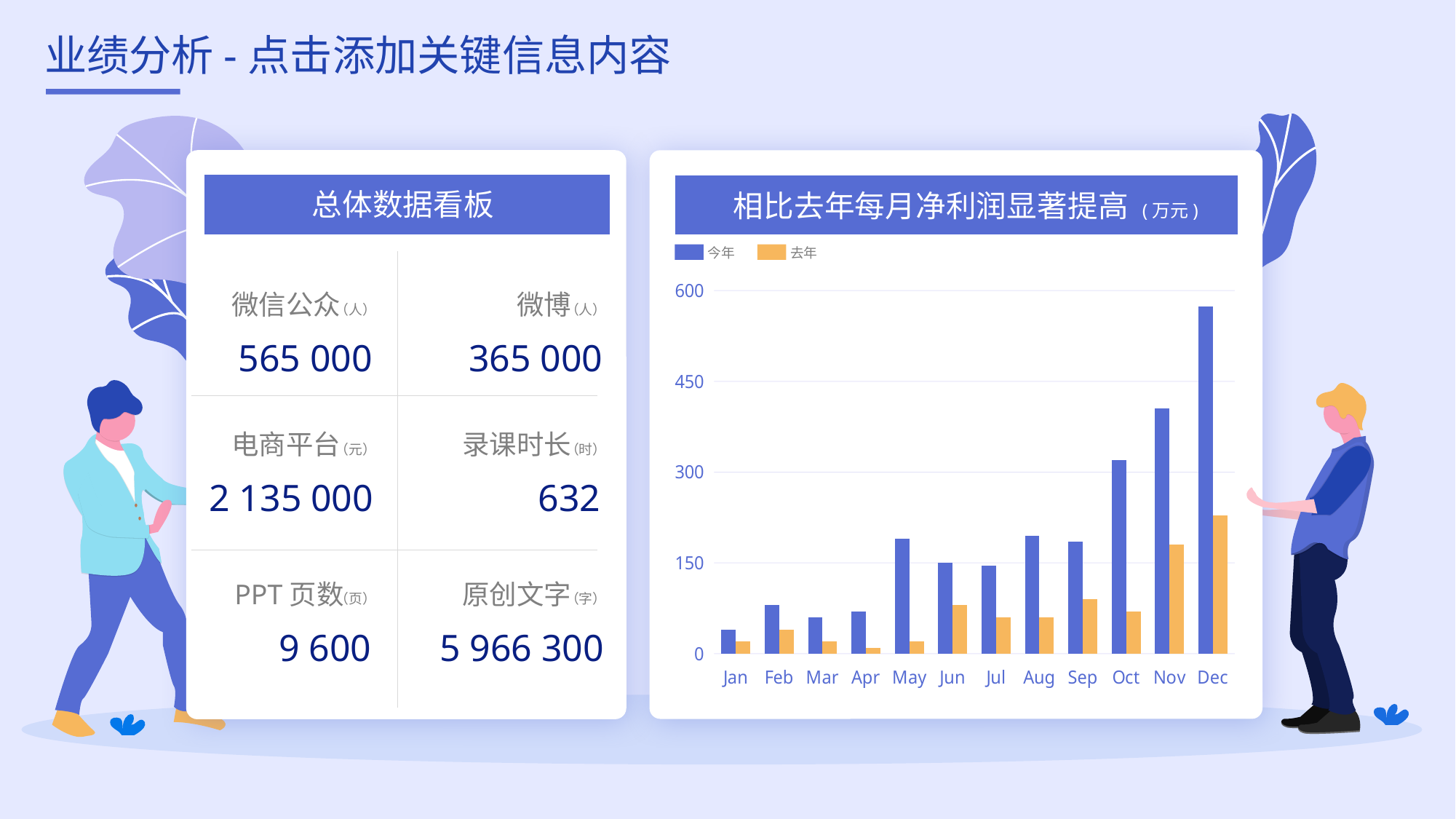
Which colour represents 去年 in the chart legend? orange How many months are shown on the x axis of the chart? 12 Is the value for 今年 in Oct greater or less than 300? greater Is the value for 去年 in Dec greater or less than 300? less Which month has the highest value for 今年? Dec Is the value for 今年 in Dec greater or less than 450? greater Do the 今年 values rise or fall from Sep to Dec? rise Which month has the highest value for 去年? Dec Which month has the lowest value for 今年? Jan How many series does the chart legend list? 2 What kind of chart is shown on the slide? bar chart Which is larger, the 今年 value for Nov or the 今年 value for Dec? Dec